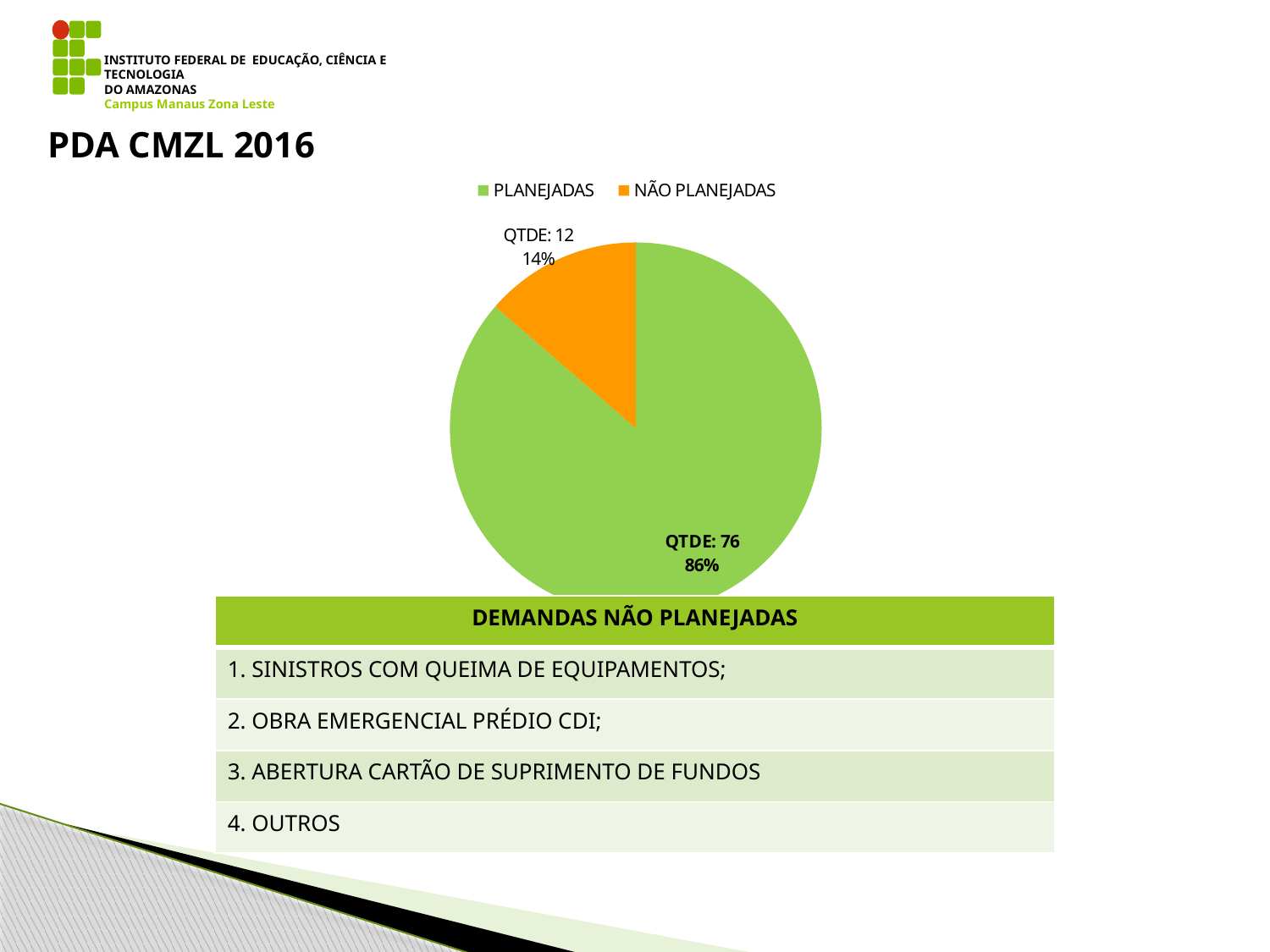
What is the quantity (QTDE) for PLANEJADAS? 76 What is the total quantity across both slices of the pie? 88 What is the difference in quantity between PLANEJADAS and NÃO PLANEJADAS? 64 Which slice is the largest? PLANEJADAS What is the quantity (QTDE) for NÃO PLANEJADAS? 12 Which is larger, the quantity for PLANEJADAS or for NÃO PLANEJADAS? PLANEJADAS How many series does the legend list? 2 What percentage share of the pie does PLANEJADAS have? 86% What colour is the NÃO PLANEJADAS slice? orange What percentage share of the pie does NÃO PLANEJADAS have? 14% Which slice is the smallest? NÃO PLANEJADAS What kind of chart is shown on the slide? pie chart